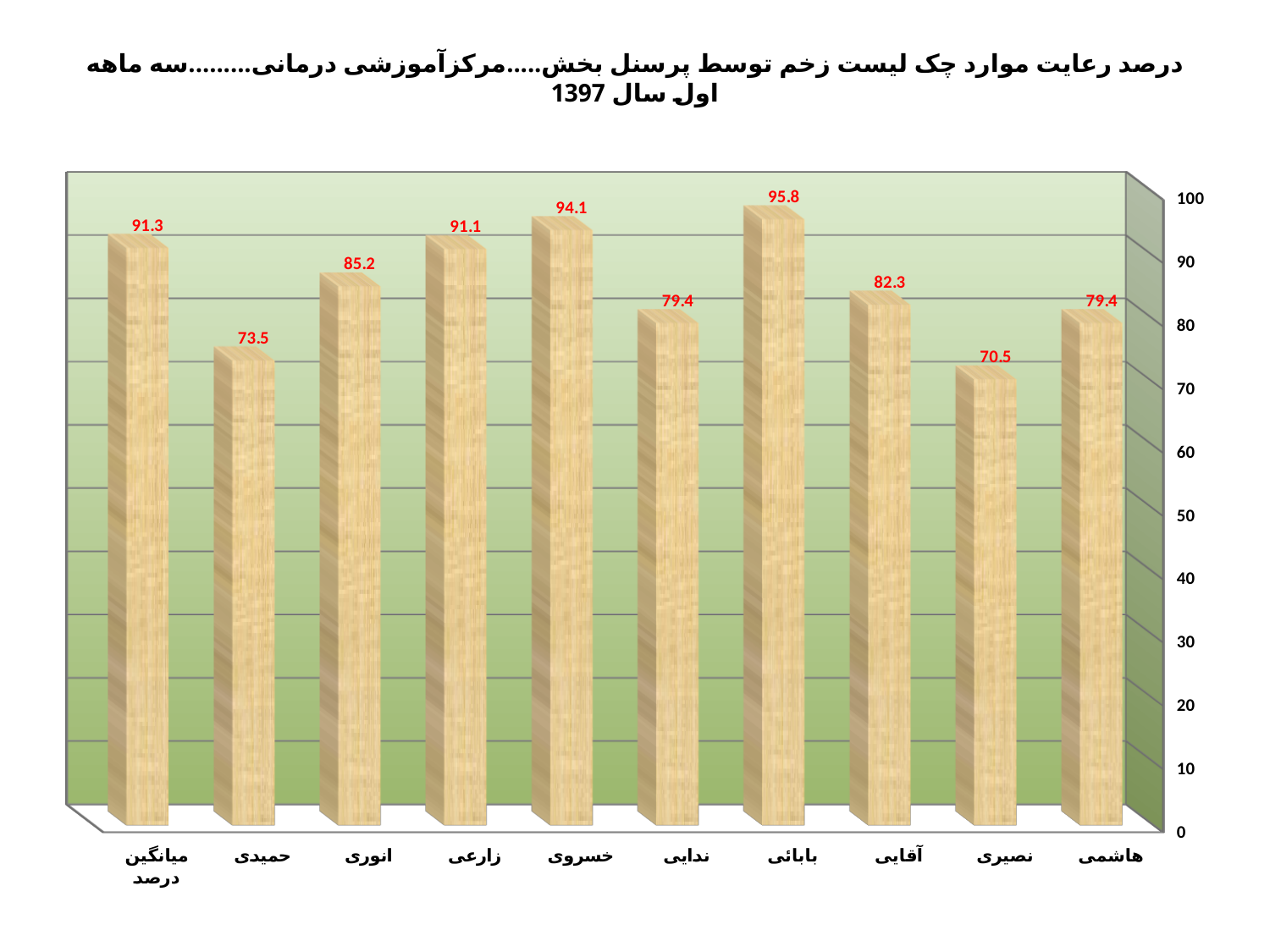
What is the maximum value shown on the vertical axis? 100 What is the value for حمیدی? 73.5 What is the value for میانگین درصد? 91.3 Which category has the highest value? بابائی Is the value for نصیری greater or less than 80? less Which is larger, the value for زارعی or the value for ندایی? زارعی What is the value for بابائی? 95.8 What kind of chart is shown on the slide? bar chart What is the difference between the values for خسروی and انوری? 8.9 How many categories are shown on the x axis? 10 What is the value for آقایی? 82.3 Which category has the lowest value? نصیری